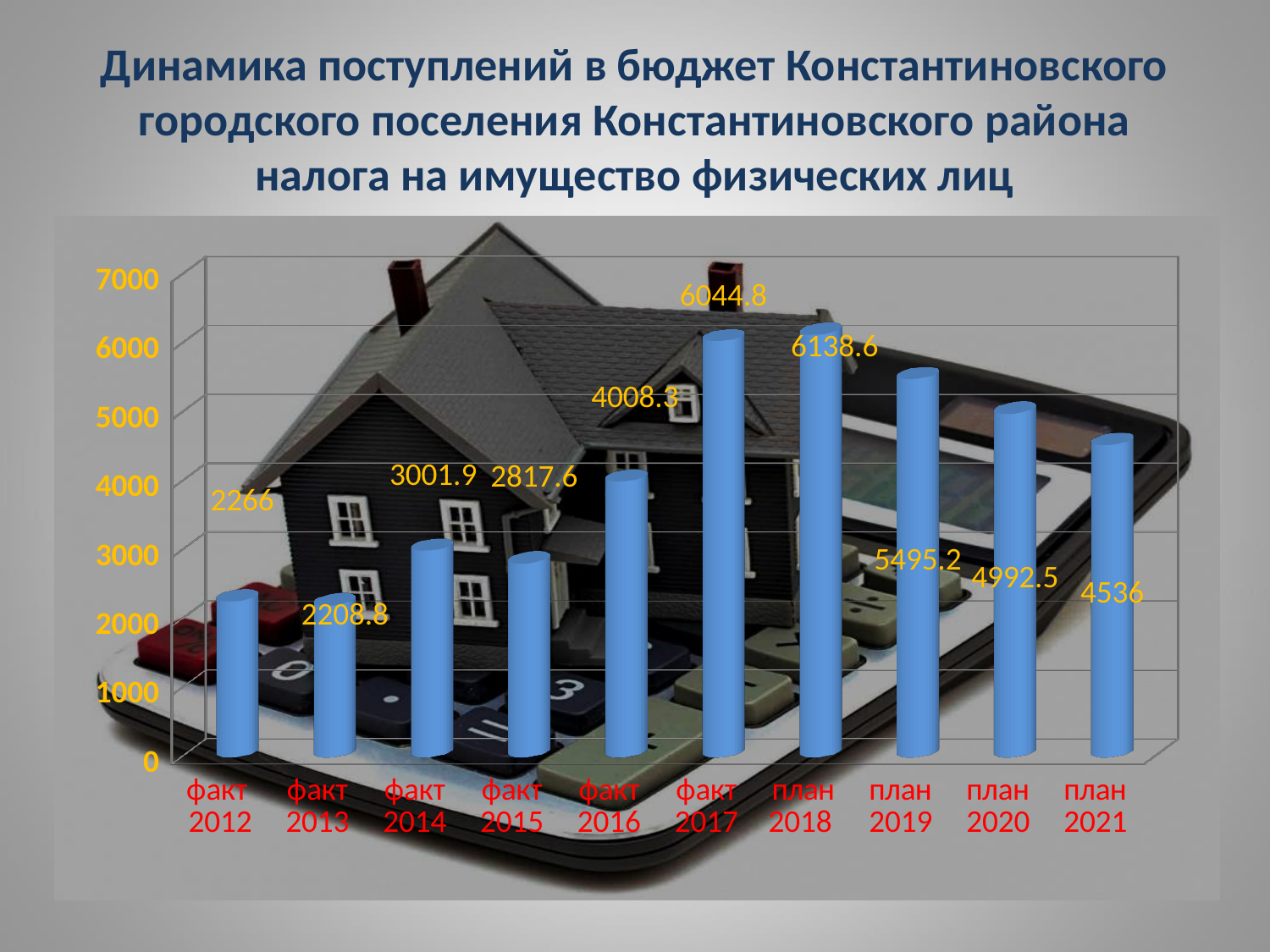
Is the value for факт 2015 greater or less than 3000? less What is the difference between the values for план 2018 and план 2021? 1602.6 What is the value for факт 2017? 6044.8 Which category has the highest value? план 2018 What is the value for план 2021? 4536 What is the value for факт 2014? 3001.9 Which category has the lowest value? факт 2013 Which is larger, the value for факт 2016 or the value for план 2020? план 2020 What is the value for план 2019? 5495.2 Do the values rise or fall from факт 2012 to факт 2017? rise How many categories are shown on the x axis? 10 What kind of chart is shown on the slide? bar chart